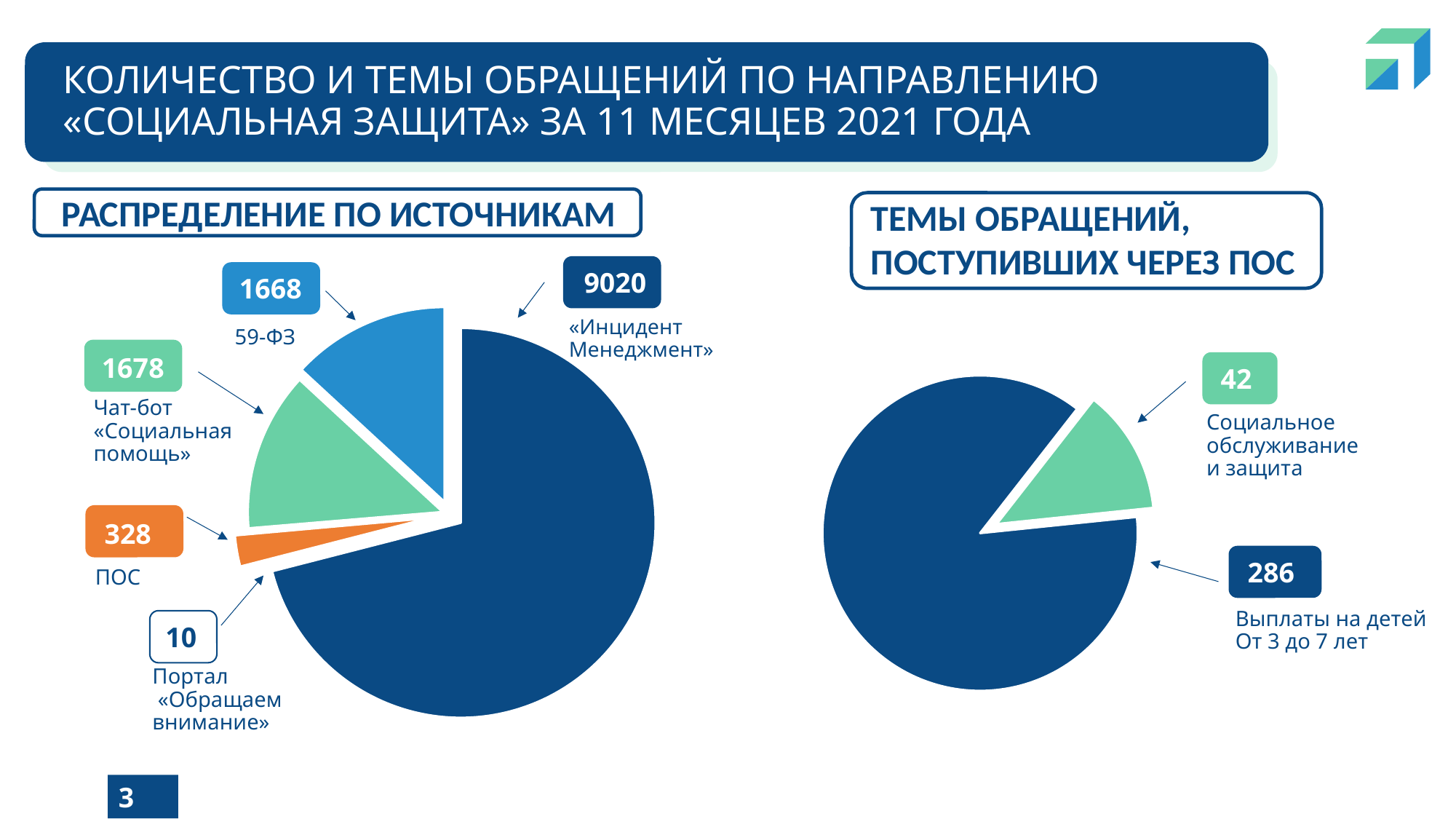
On the chart «Распределение по источникам», which source has the largest value? «Инцидент Менеджмент» On the chart «Темы обращений, поступивших через ПОС», which topic has the larger value: «Выплаты на детей от 3 до 7 лет» or «Социальное обслуживание и защита»? «Выплаты на детей от 3 до 7 лет» On the chart «Распределение по источникам», which source has the smallest value? Портал «Обращаем внимание» On the chart «Темы обращений, поступивших через ПОС», what is the difference between the two values? 244 What kind of chart is used for «Темы обращений, поступивших через ПОС»? Pie chart On the chart «Распределение по источникам», what is the difference between the values for Чат-бот «Социальная помощь» and 59-ФЗ? 10 On the chart «Распределение по источникам», how many slices does the pie have? 5 On the chart «Распределение по источникам», what is the value for ПОС? 328 On the chart «Распределение по источникам», what is the value for «Инцидент Менеджмент»? 9020 On the chart «Темы обращений, поступивших через ПОС», what is the value for «Выплаты на детей от 3 до 7 лет»? 286 On the chart «Распределение по источникам», what is the value for Чат-бот «Социальная помощь»? 1678 On the chart «Темы обращений, поступивших через ПОС», what is the value for «Социальное обслуживание и защита»? 42